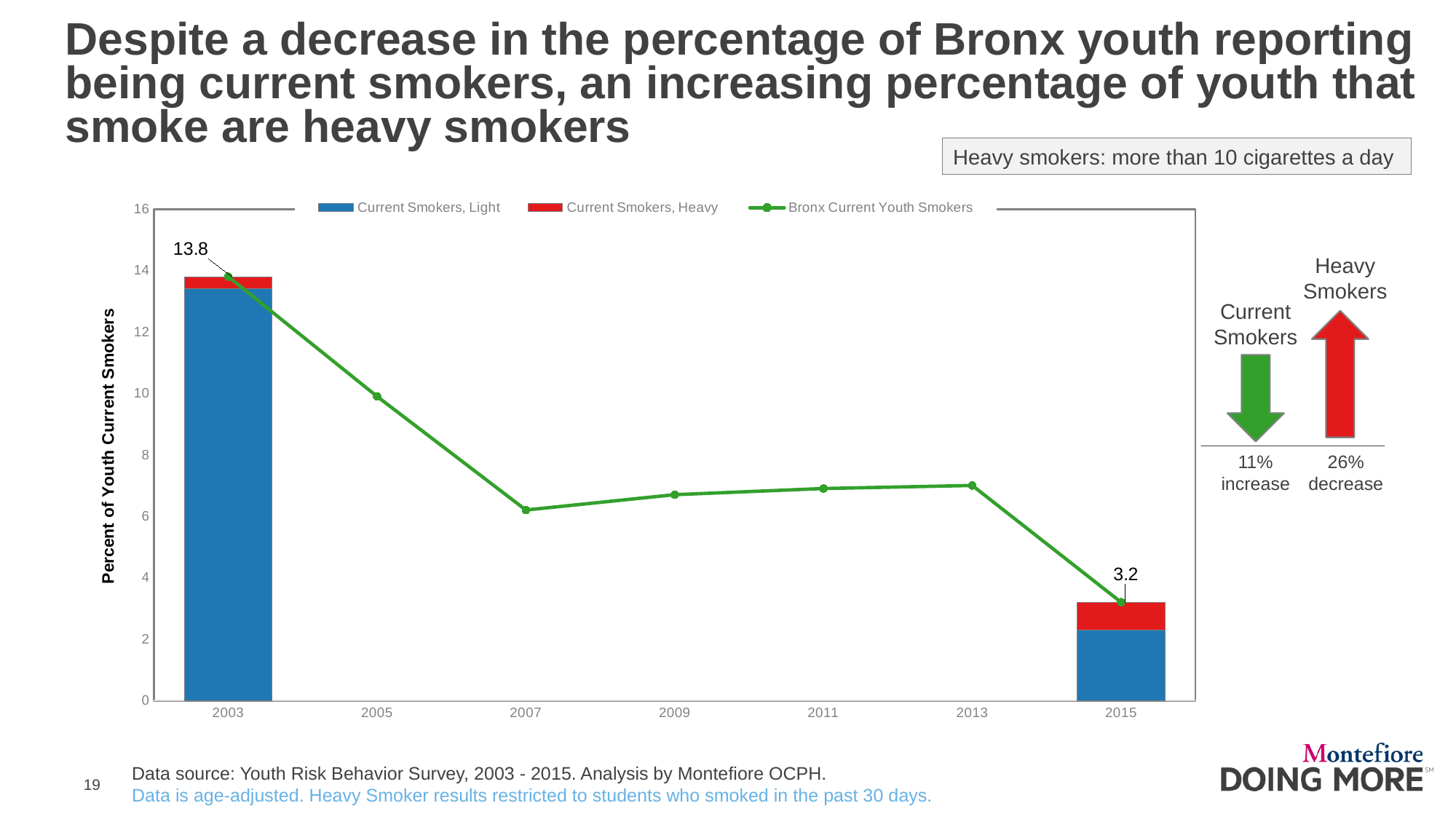
Is the Bronx Current Youth Smokers value for 2007 greater or less than 8? less Is the Bronx Current Youth Smokers value for 2005 greater or less than 8? greater In which year is the Bronx Current Youth Smokers value lowest? 2015 What is the value of Bronx Current Youth Smokers in 2015? 3.2 What is the title of the y axis? Percent of Youth Current Smokers Which year has the larger Bronx Current Youth Smokers value, 2005 or 2007? 2005 Does the Bronx Current Youth Smokers line rise or fall from 2003 to 2007? fall How many series does the legend list? 3 What is the value of Bronx Current Youth Smokers in 2003? 13.8 By how much did the Bronx Current Youth Smokers value fall from 2003 to 2015? 10.6 In which year is the Bronx Current Youth Smokers value highest? 2003 How many years are shown on the x axis? 7